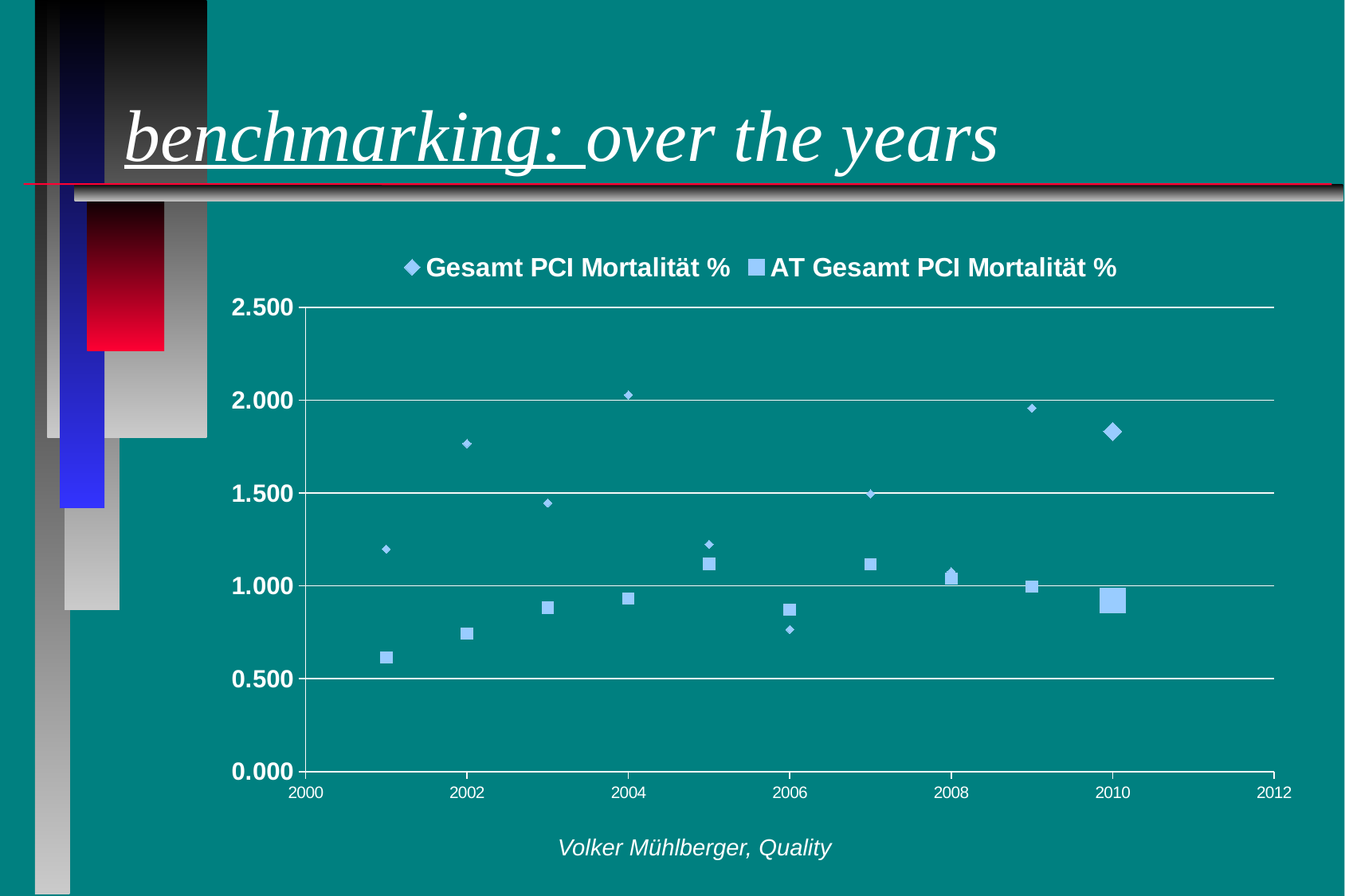
How many data points are plotted for the Gesamt PCI Mortalität % series? 10 In 2002, which series has the larger value, Gesamt PCI Mortalität % or AT Gesamt PCI Mortalität %? Gesamt PCI Mortalität % In which year is the Gesamt PCI Mortalität % value lowest? 2006 Is the Gesamt PCI Mortalität % value for 2002 greater or less than 1.500? greater How many series does the legend list? 2 What kind of chart is shown on the slide? scatter chart In which year is the AT Gesamt PCI Mortalität % value lowest? 2001 In which year is the Gesamt PCI Mortalität % value highest? 2004 Is the Gesamt PCI Mortalität % value for 2006 greater or less than 1.000? less What are the two series named in the legend? Gesamt PCI Mortalität % and AT Gesamt PCI Mortalität % Is the AT Gesamt PCI Mortalität % value for 2001 greater or less than 1.000? less